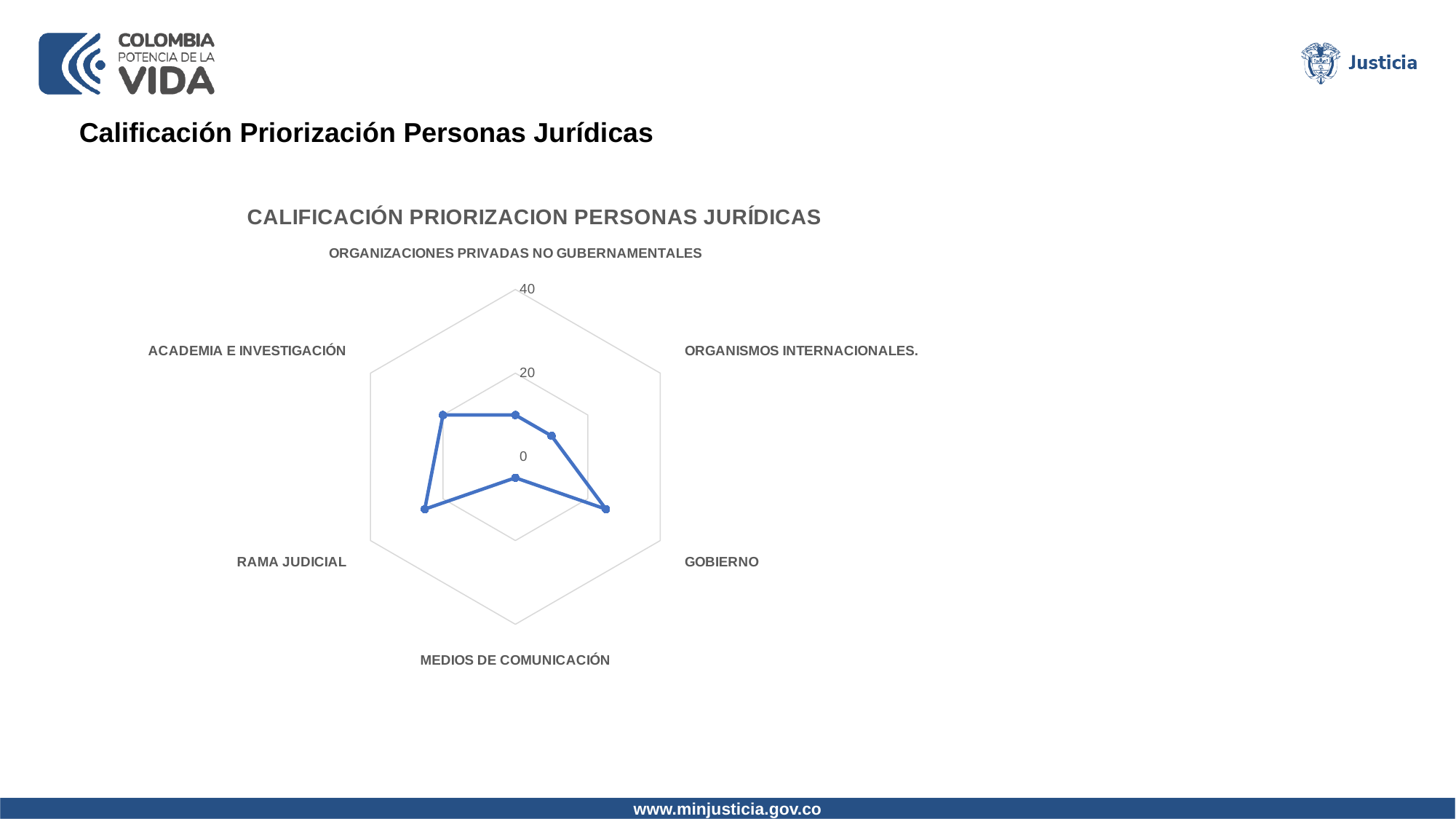
What kind of chart is shown on the slide? Radar chart Is the value for ORGANIZACIONES PRIVADAS NO GUBERNAMENTALES greater or less than 20? less Which has the larger value, ACADEMIA E INVESTIGACIÓN or ORGANIZACIONES PRIVADAS NO GUBERNAMENTALES? ACADEMIA E INVESTIGACIÓN Which has the larger value, GOBIERNO or MEDIOS DE COMUNICACIÓN? GOBIERNO Which category has the lowest value on the chart? MEDIOS DE COMUNICACIÓN What is the title of the chart? CALIFICACIÓN PRIORIZACION PERSONAS JURÍDICAS Is the value for MEDIOS DE COMUNICACIÓN greater or less than 20? less Is the value for GOBIERNO greater or less than 20? greater How many categories are plotted on the radar chart? 6 What is the highest value shown on the chart's axis scale? 40